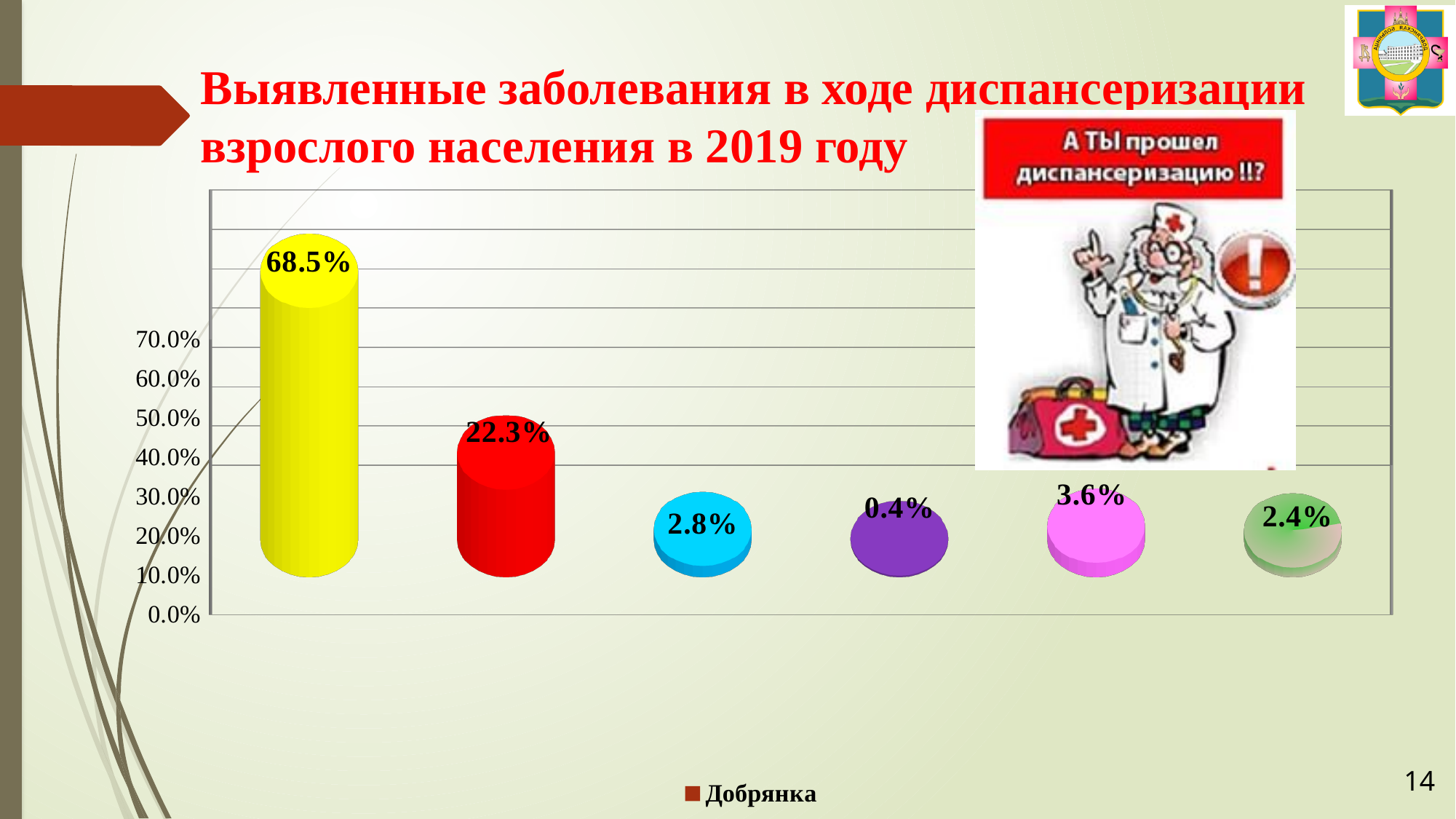
How many bars are plotted in the chart? 6 What value is shown on the green bar (rightmost)? 2.4% What value is shown on the red bar (second from the left)? 22.3% What is the name of the series shown in the chart legend? Добрянка What value is shown on the yellow bar (first from the left)? 68.5% What type of chart is shown on the slide? bar chart What is the difference between the yellow bar's value and the red bar's value? 46.2% What value is shown on the blue bar (third from the left)? 2.8% What value is shown on the purple bar (fourth from the left)? 0.4% What value is shown on the pink bar (fifth from the left)? 3.6% How many series does the chart legend list? 1 Which bar has the lowest value in the chart? the purple bar (0.4%)